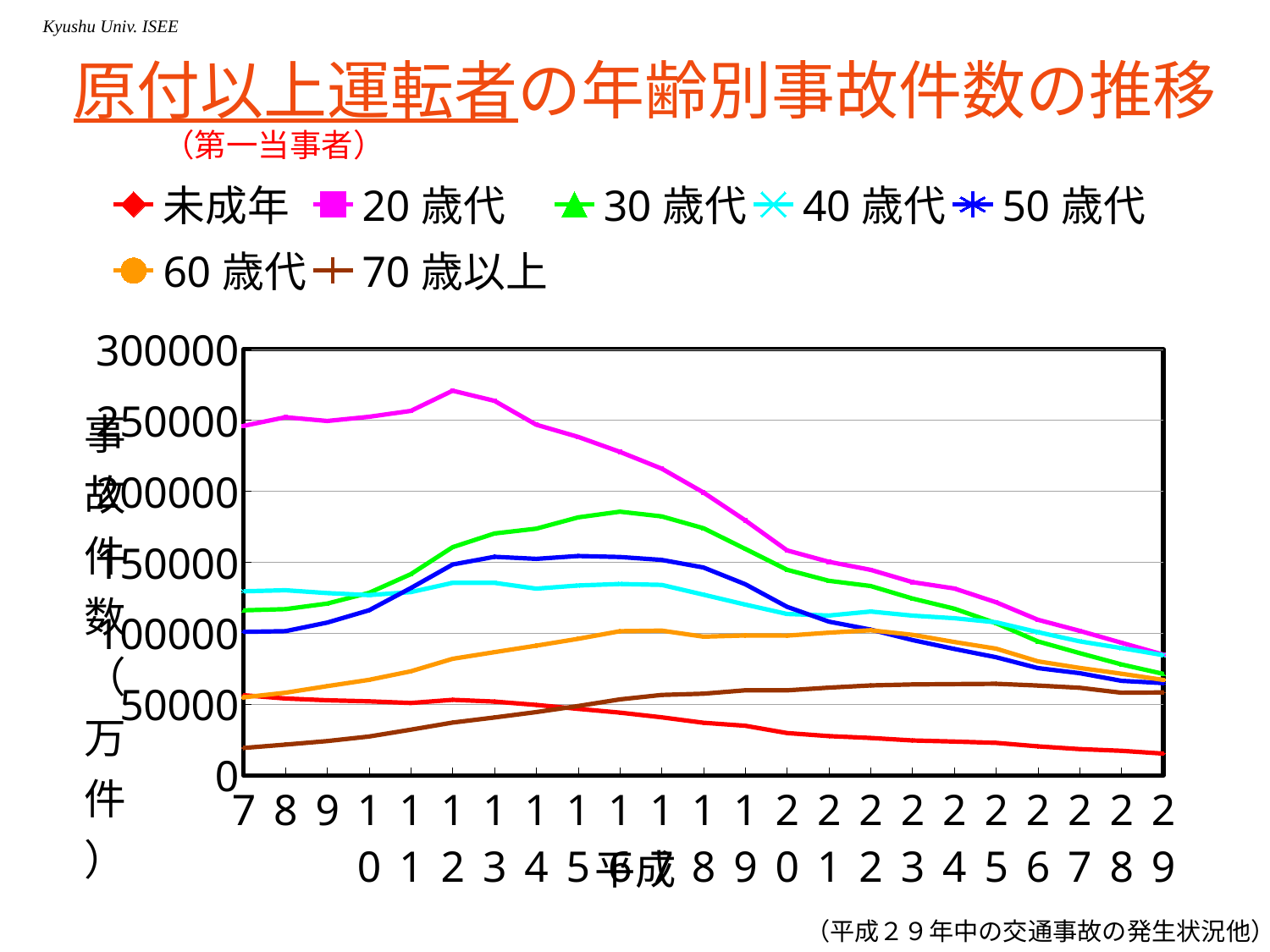
How many years (x-axis points) are plotted on the chart? 23 Does the 20歳代 series rise or fall overall from 平成12 to 平成29? fall Is the value for 30歳代 in 平成16 greater or less than 150000? greater Does the 70歳以上 series rise or fall overall from 平成7 to 平成20? rise Which series has the lowest value in 平成7? 70歳以上 Is the value for 20歳代 in 平成12 greater or less than 250000? greater Is the value for 70歳以上 in 平成7 greater or less than 50000? less What kind of chart is shown on the slide? line chart In 平成29, which is larger: the value for 未成年 or the value for 70歳以上? 70歳以上 Which series has the highest value in 平成7? 20歳代 How many series does the legend list? 7